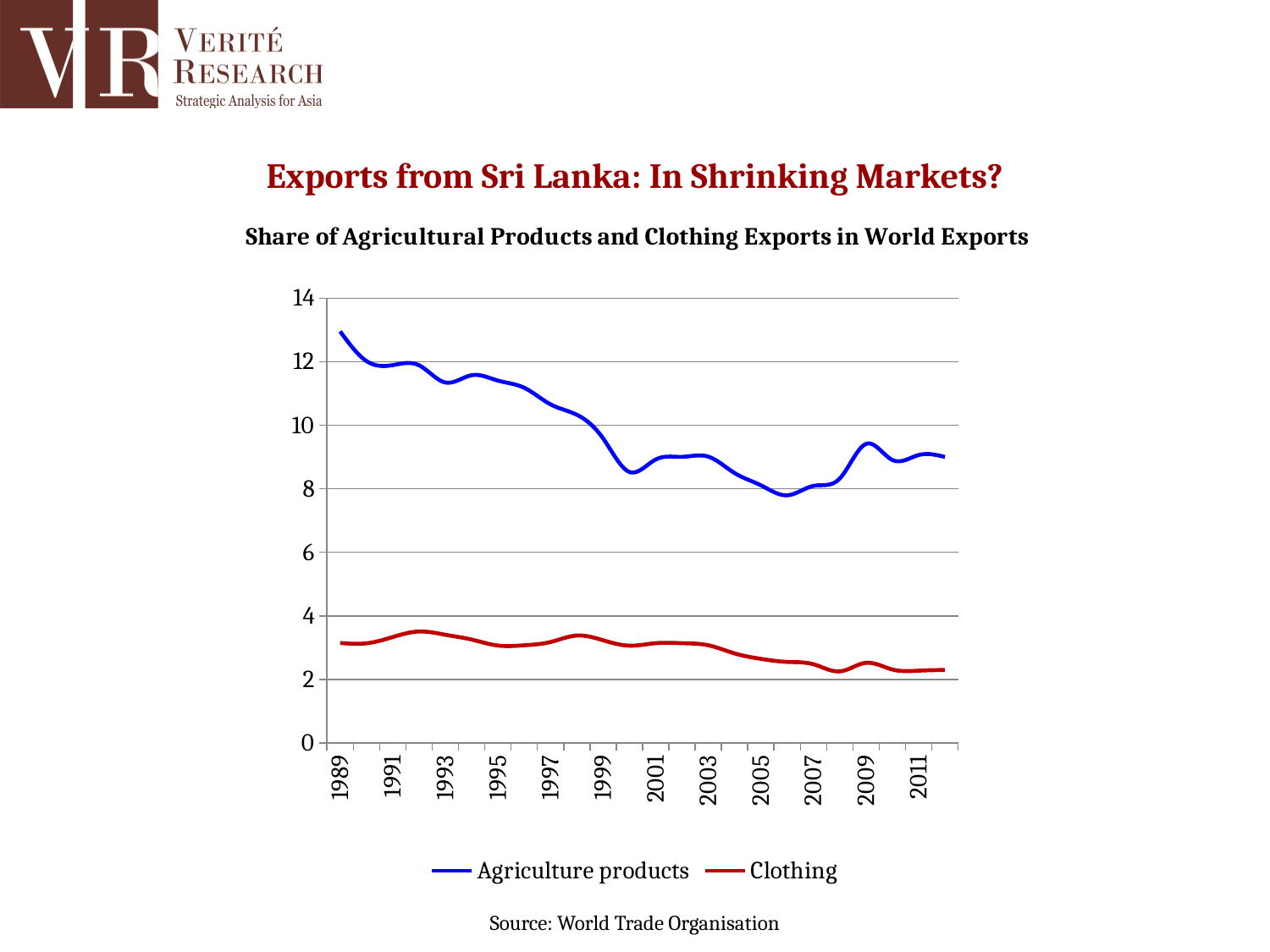
Is the value for Agriculture products in 1989 greater or less than 12? greater How many year labels are shown on the x axis? 12 Which series has the higher value in 2005, Agriculture products or Clothing? Agriculture products Is the value for Clothing in 1989 greater or less than 4? less Overall, does the Clothing line rise or fall from 1989 to 2012? Fall How many series does the legend list? 2 Overall, does the Agriculture products line rise or fall from 1989 to 2012? Fall In which year does the Agriculture products line reach its highest value? 1989 What are the two series shown in the legend? Agriculture products and Clothing Is the value for Agriculture products in 2011 greater or less than 10? less What kind of chart is shown on the slide? Line chart What is the title of the chart? Share of Agricultural Products and Clothing Exports in World Exports